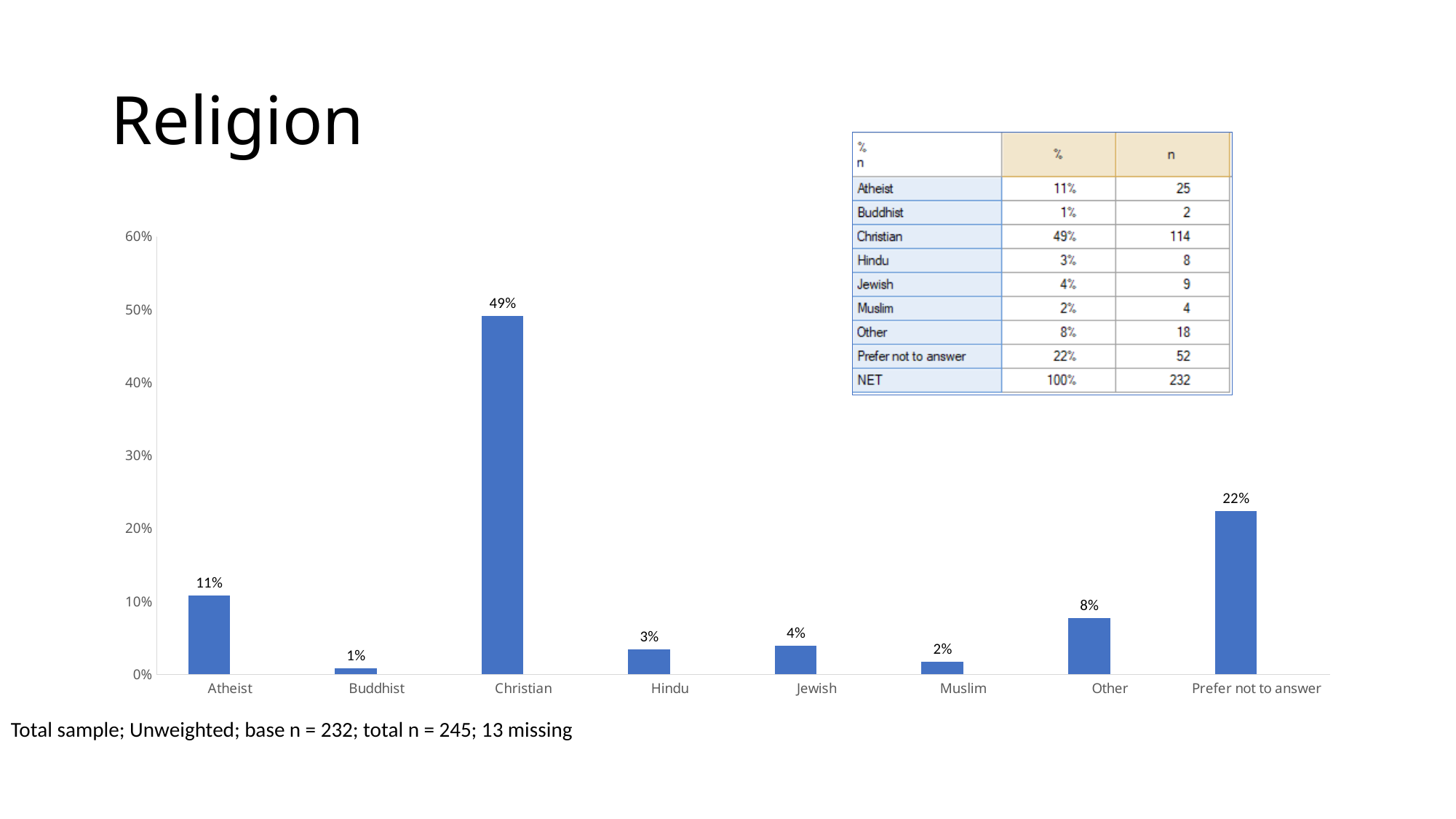
Is the value for Atheist greater or less than 10%? greater What is the value for Atheist? 11% What is the difference between the values for Hindu and Muslim? 1% How many categories are shown on the x axis? 8 What is the difference between the values for Christian and Prefer not to answer? 27% What is the value for Christian? 49% Which is larger, the value for Other or the value for Jewish? Other Which category has the highest value? Christian Which category has the lowest value? Buddhist What is the value for Prefer not to answer? 22% What is the title of the slide containing the chart? Religion What kind of chart is shown on the slide? bar chart